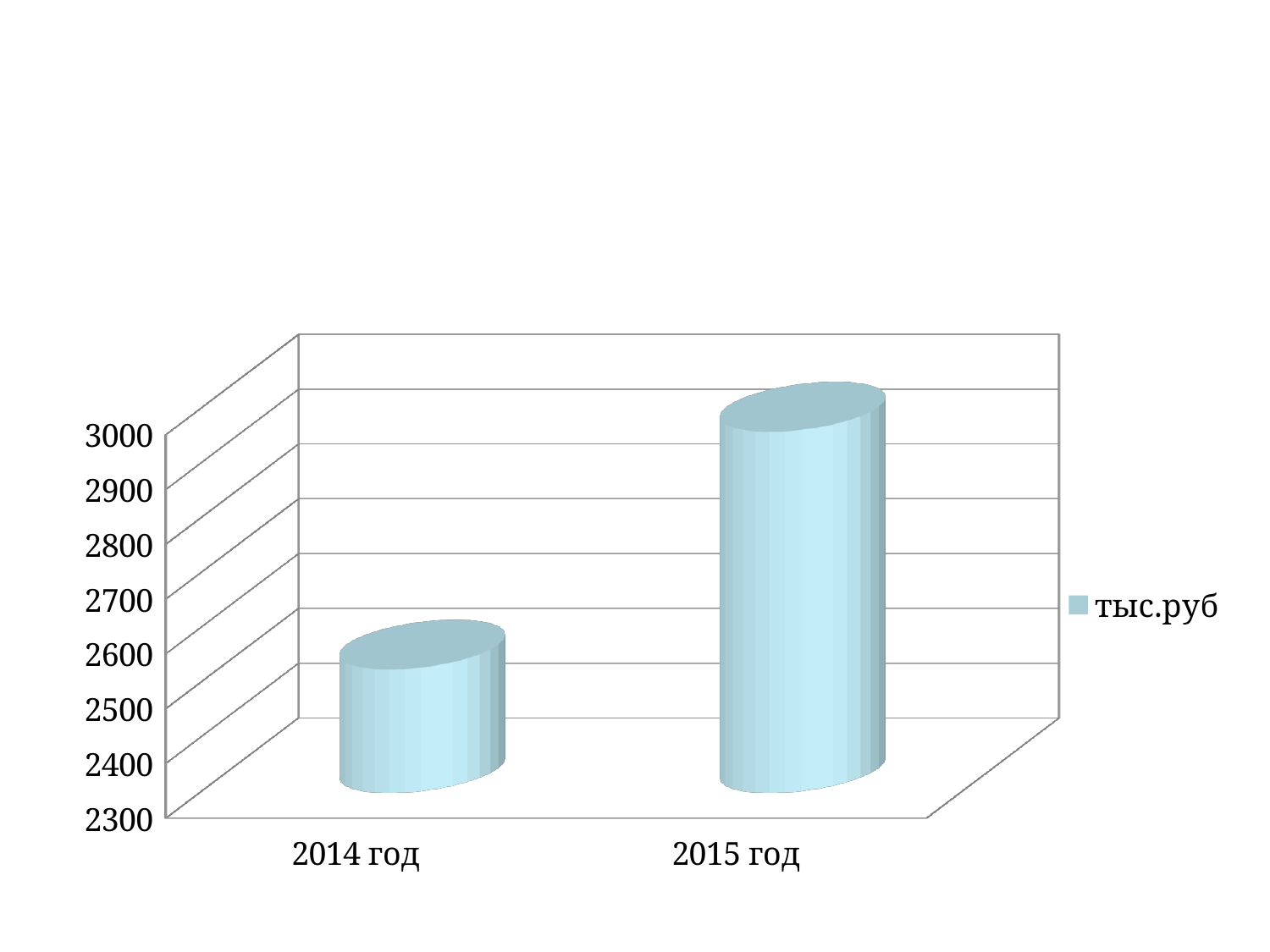
Do the values rise or fall from 2014 год to 2015 год? rise What is the name of the series in the legend? тыс.руб Which is larger, the value for 2014 год or for 2015 год? 2015 год Is the value for 2015 год greater or less than 2800? greater How many categories are shown on the x axis? 2 Which category has the lowest value? 2014 год How many series does the legend list? 1 What kind of chart is shown on the slide? bar chart Is the value for 2014 год greater or less than 2400? greater Which category has the highest value? 2015 год Is the value for 2014 год greater or less than 2800? less What is the lowest value shown on the vertical axis? 2300